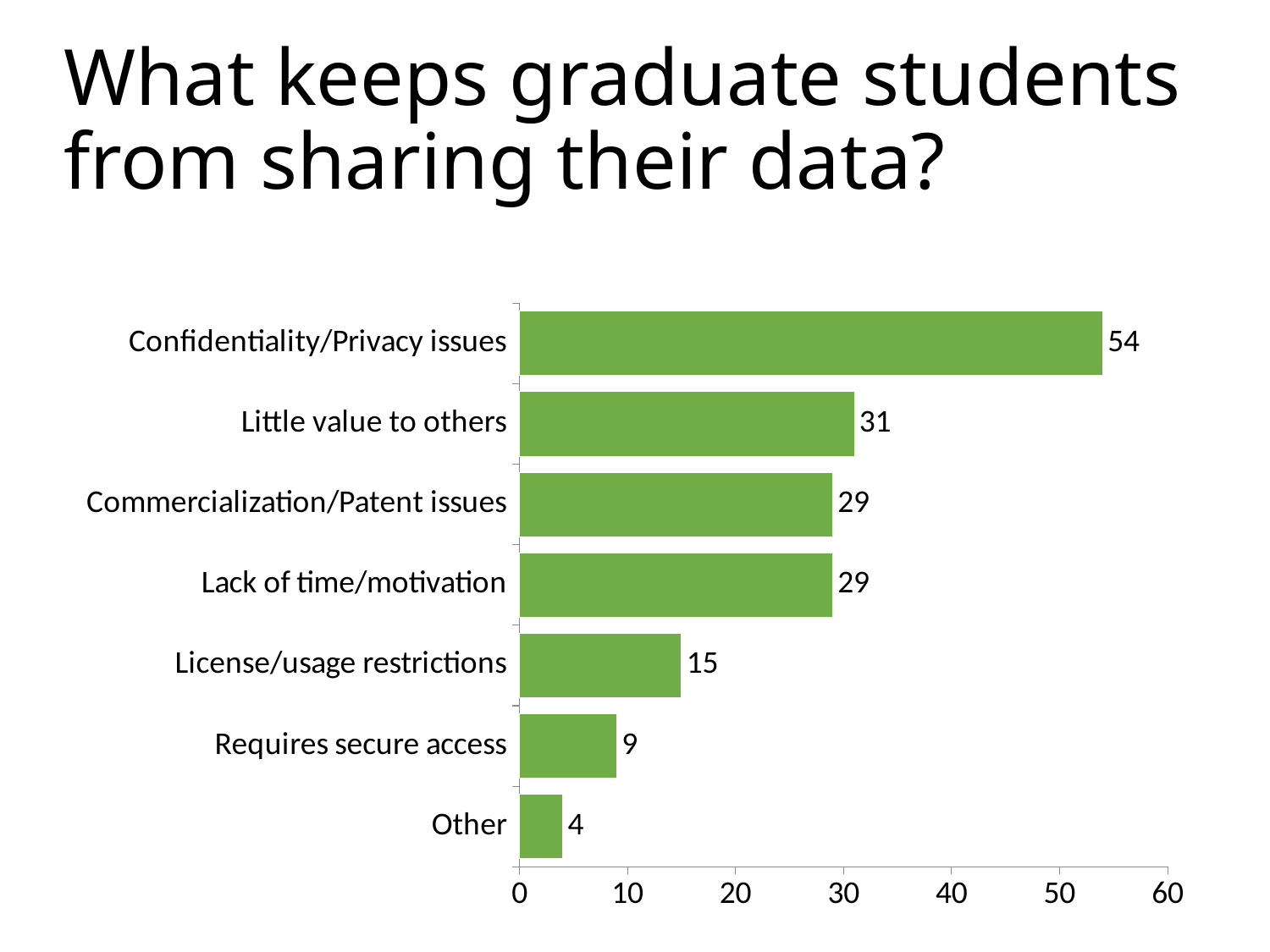
What is the title of the slide? What keeps graduate students from sharing their data? Is the value for Lack of time/motivation greater or less than 20? greater What is the value for Little value to others? 31 What kind of chart is shown on the slide? Bar chart Which is larger, the value for License/usage restrictions or the value for Requires secure access? License/usage restrictions What is the value for Requires secure access? 9 Which category has the lowest value? Other What is the value for Confidentiality/Privacy issues? 54 What is the difference between the values for Confidentiality/Privacy issues and Little value to others? 23 Which category has the highest value? Confidentiality/Privacy issues How many categories are shown in the chart? 7 What is the value for License/usage restrictions? 15